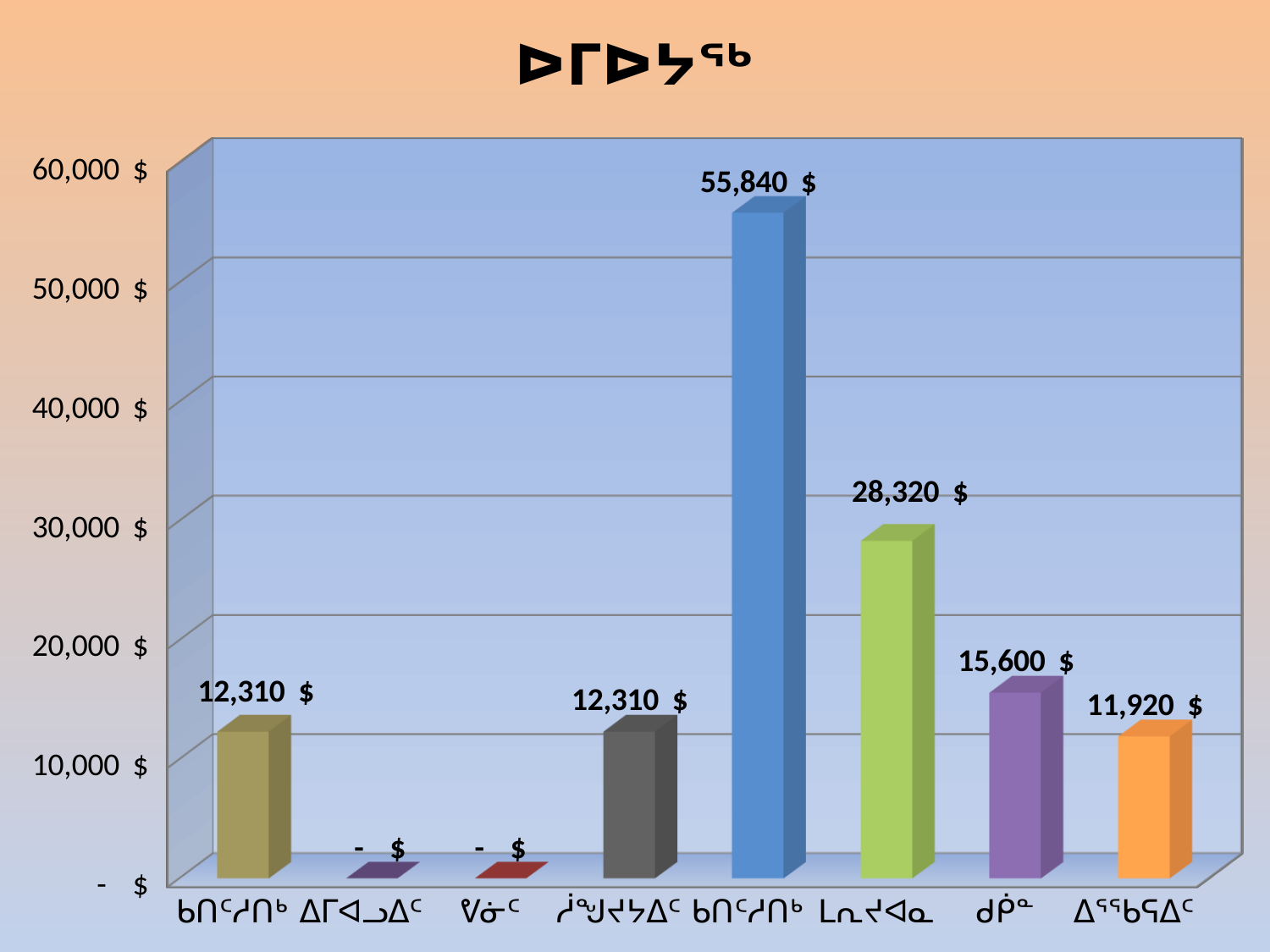
How many bars (categories) are shown in the chart? 8 What is the highest value shown on the vertical axis? 60,000 $ What is the value of the tallest bar (the blue bar, fifth from the left)? 55,840 $ What is the value of the green bar (sixth from the left)? 28,320 $ What is the value of the orange bar (the last bar on the right)? 11,920 $ What is the difference between the blue bar (55,840 $) and the green bar (28,320 $)? 27,520 $ What is the value of the purple bar (seventh from the left)? 15,600 $ What is the difference between the purple bar (15,600 $) and the orange bar (11,920 $)? 3,680 $ Which bar has the highest value: the blue bar or the green bar? the blue bar What type of chart is shown on the slide? bar chart What value is labelled for the second and third bars from the left? - $ What is the value of the first bar on the left (the olive-coloured bar)? 12,310 $